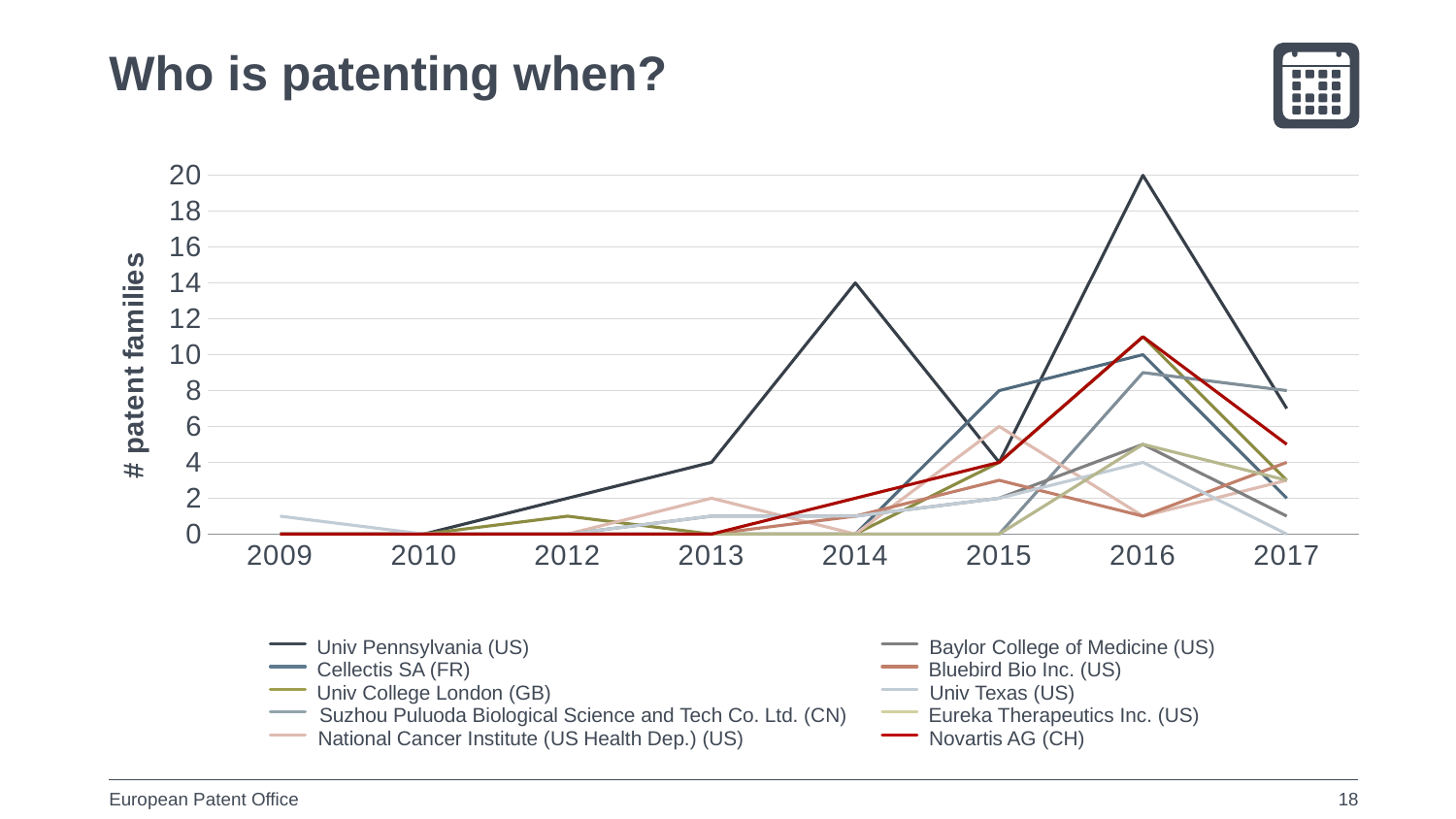
What kind of chart is shown on the slide? line chart In 2016, which has more patent families: Univ Pennsylvania (US) or Novartis AG (CH)? Univ Pennsylvania (US) How many patent families does Univ Pennsylvania (US) have in 2014? 14 What is the difference between Univ Pennsylvania (US)'s values in 2016 and 2014? 6 Is the value for Novartis AG (CH) in 2016 greater or less than 10? greater How many years are shown on the x axis? 8 Does the Univ Pennsylvania (US) line rise or fall between 2010 and 2014? rise Is the value for Univ Pennsylvania (US) in 2017 greater or less than 10? less In which year does Univ Pennsylvania (US) reach its highest number of patent families? 2016 How many patent families does Univ Pennsylvania (US) have in 2016? 20 What is the label on the y axis of the chart? # patent families How many series does the legend list? 10